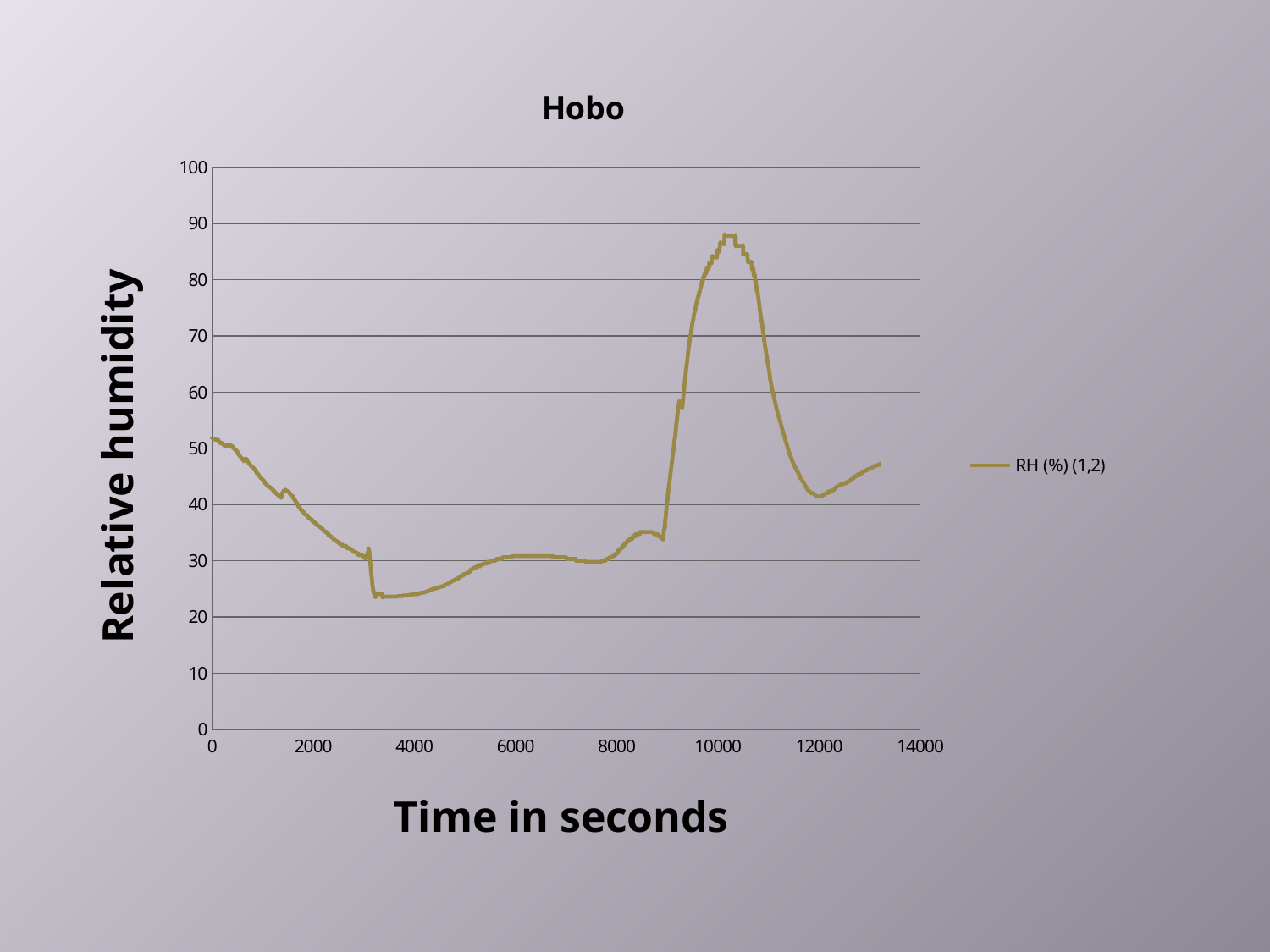
Near which x-axis tick does the line reach its highest value? 10000 Does the relative humidity rise or fall between 9000 and 10000 seconds? rise Is the relative humidity at 4000 seconds greater or less than 30? less How many series does the legend list? 1 Is the highest value reached by the line greater or less than 80? greater Is the relative humidity at time 0 greater or less than 50? greater What is the name of the series shown in the legend? RH (%) (1,2) What is the title of the chart? Hobo What kind of chart is shown on the slide? line chart Does the relative humidity rise or fall between 0 and 3000 seconds? fall